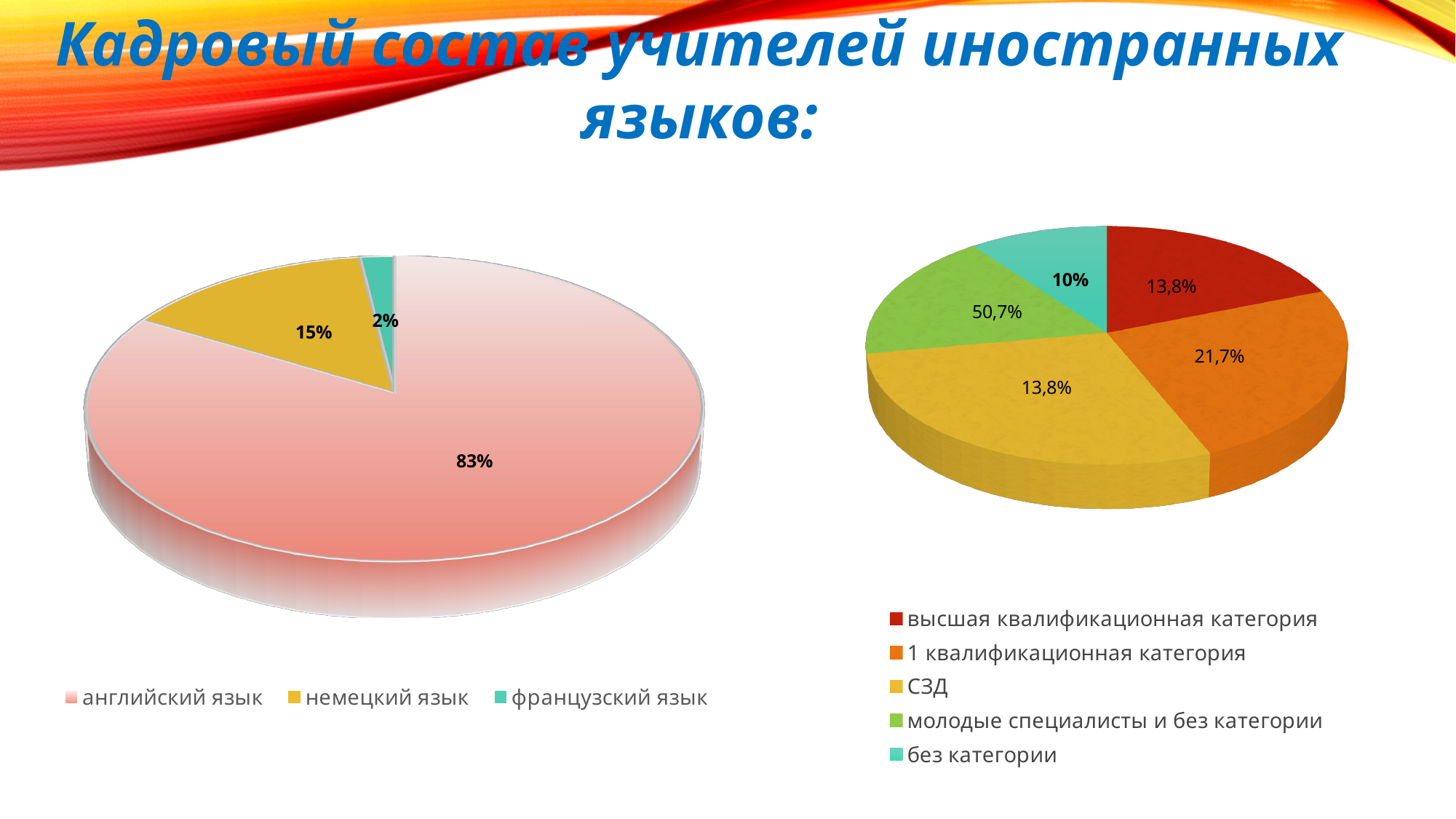
In the left pie chart, what share is shown for английский язык? 83% In the right pie chart, what share is shown for без категории? 10% In the left pie chart, which language has the largest share? английский язык How many categories does the legend of the right pie chart list? 5 How many categories does the legend of the left pie chart list? 3 In the right pie chart, what share is shown for высшая квалификационная категория? 13,8% In the right pie chart, what share is shown for 1 квалификационная категория? 21,7% What type of chart is the left chart on the slide? pie chart In the left pie chart, what share is shown for французский язык? 2% In the left pie chart, which language has the smallest share? французский язык In the left pie chart, what share is shown for немецкий язык? 15% In the left pie chart, how many percentage points larger is the share for английский язык than for немецкий язык? 68 percentage points